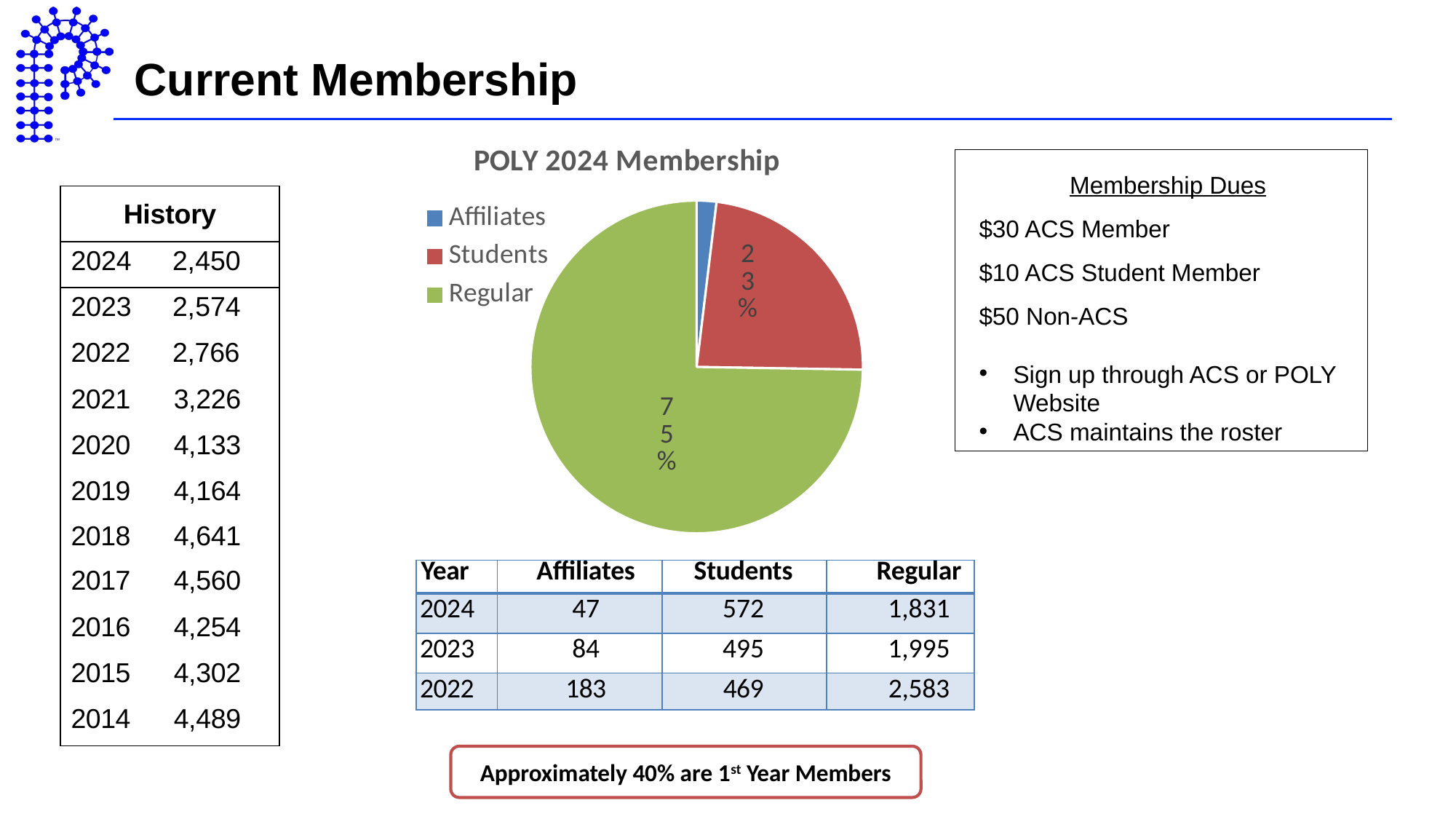
How many slices does the pie chart have? 3 What share of the pie chart is labelled for Students? 23% Which slice is larger in the pie chart, Students or Affiliates? Students What share of the pie chart is labelled for Regular members? 75% What is the title of the pie chart? POLY 2024 Membership How many categories does the legend of the pie chart list? 3 What kind of chart is shown on the slide? pie chart By how many percentage points does the Regular share exceed the Students share in the pie chart? 52% Is the Affiliates share of the pie chart greater or less than 10%? less Which category has the largest slice in the pie chart? Regular What colour is the Regular slice in the pie chart? green Which category has the smallest slice in the pie chart? Affiliates